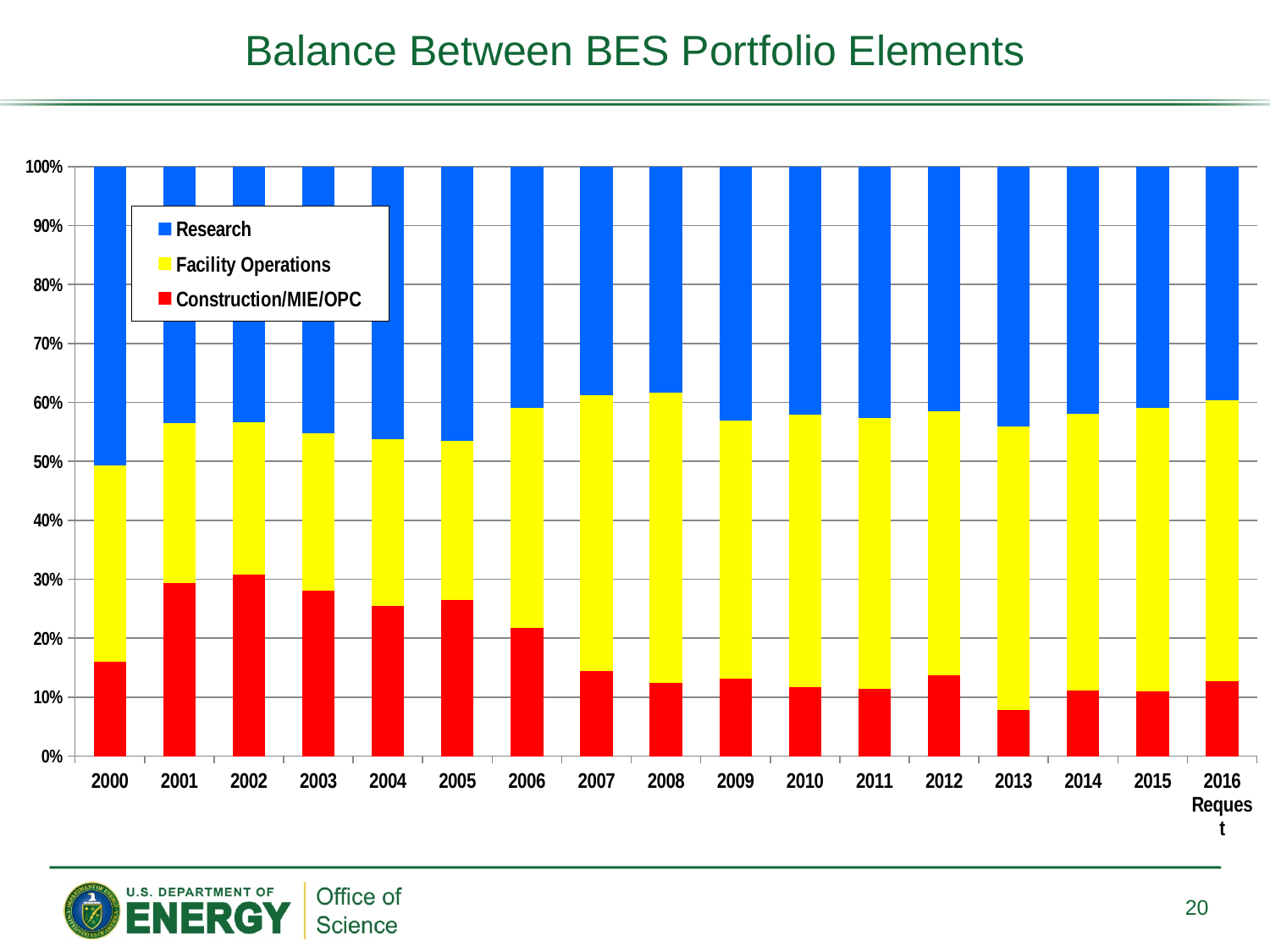
What does each stacked bar total? 100% Is the Construction/MIE/OPC share for 2001 greater or less than 20%? greater In which year is the Construction/MIE/OPC share the lowest? 2013 In which year is the Construction/MIE/OPC share the highest? 2002 Which colour represents Facility Operations in the chart? Yellow How many years (categories) are shown along the x axis? 17 How many series does the legend list? 3 Is the Construction/MIE/OPC share for 2013 greater or less than 10%? less What is the title of the chart? Balance Between BES Portfolio Elements What kind of chart is shown on the slide? Stacked bar chart In which year is the Facility Operations share the lowest? 2002 Which year has the larger Construction/MIE/OPC share, 2002 or 2013? 2002